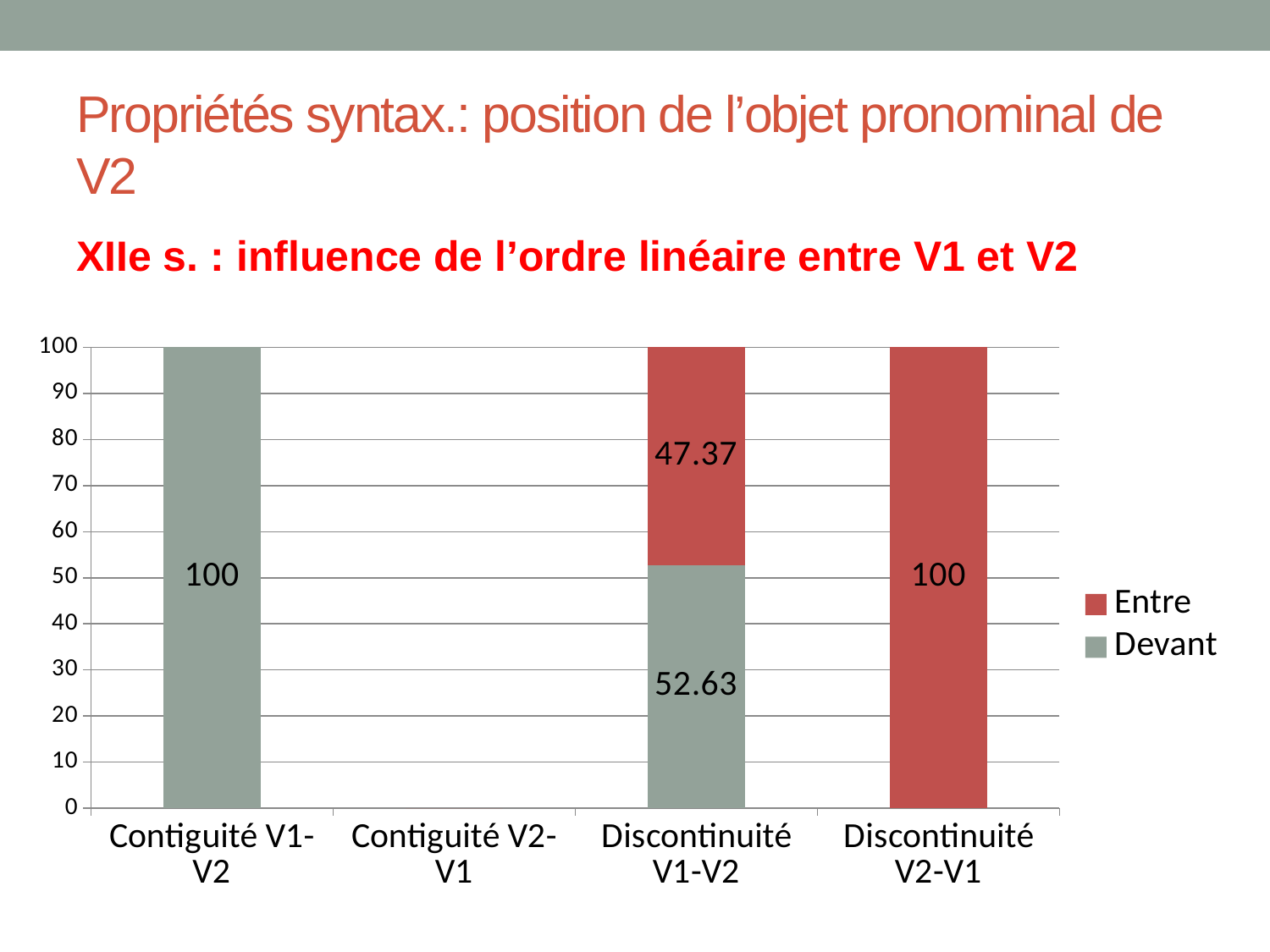
What is the value of the Entre series for Discontinuité V1-V2? 47.37 Which category has no bar plotted? Contiguité V2-V1 Which colour represents the Entre series in the legend? Red What is the total of the stacked bar for Discontinuité V1-V2? 100 What is the difference between the Devant and Entre values for Discontinuité V1-V2? 5.26 How many categories are shown on the x axis? 4 What is the value of the Devant series for Discontinuité V1-V2? 52.63 What is the value of the Entre series for Discontinuité V2-V1? 100 For Discontinuité V1-V2, which series has the larger value, Entre or Devant? Devant How many series does the legend list? 2 What is the value of the Devant series for Contiguité V1-V2? 100 What kind of chart is shown on the slide? Stacked bar chart